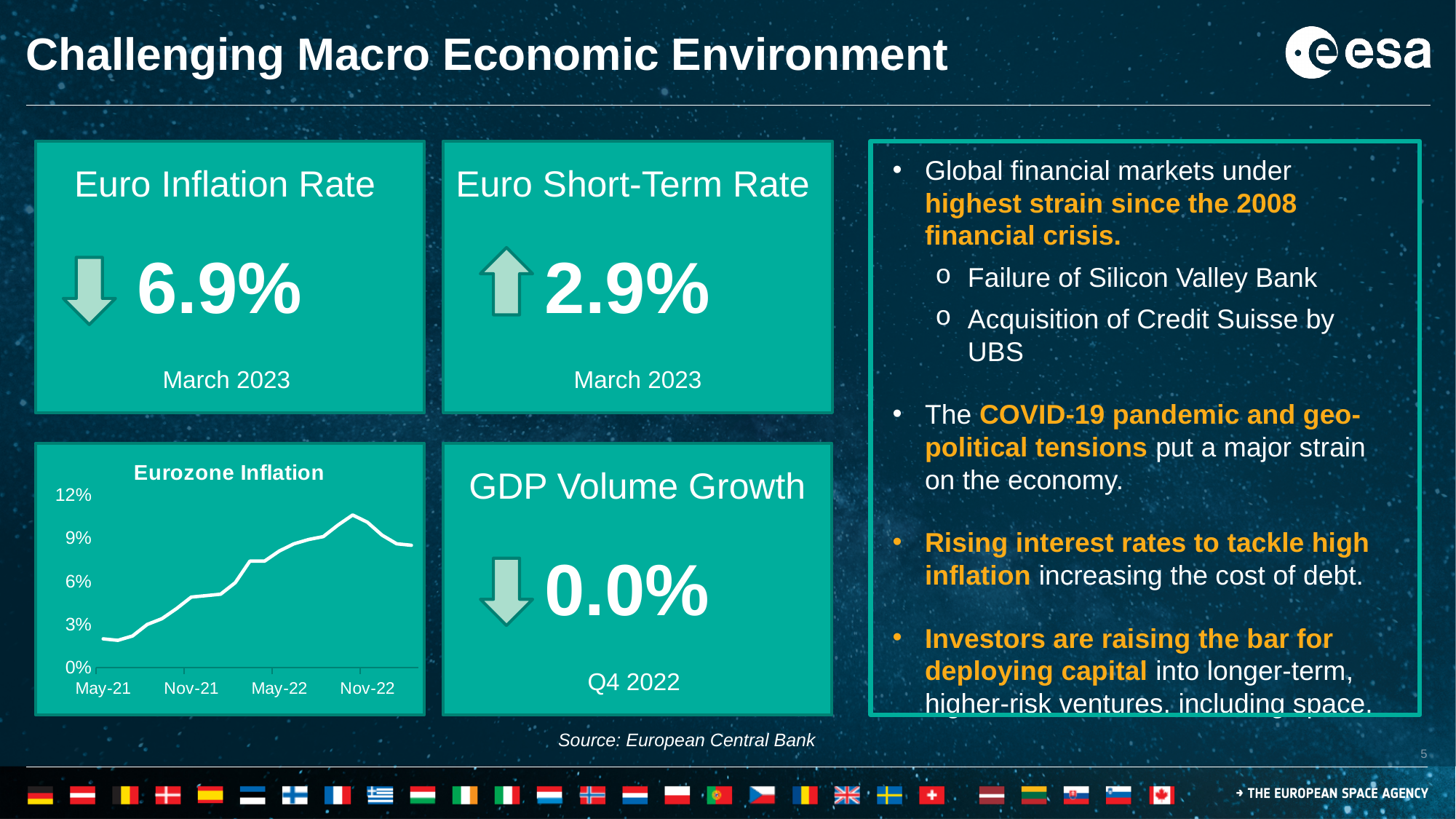
In the Eurozone Inflation chart, which is larger, the value at Nov-22 or the value at May-21? Nov-22 In the Eurozone Inflation chart, is the value at Nov-22 greater or less than 9%? greater In the Eurozone Inflation chart, is the value at Nov-21 greater or less than 6%? less In the Eurozone Inflation chart, does the inflation rate generally rise or fall from May-21 to Nov-22? rise What is the highest value shown on the y-axis of the Eurozone Inflation chart? 12% How many date labels are shown on the x-axis of the Eurozone Inflation chart? 4 In the Eurozone Inflation chart, is the value at May-22 greater or less than 6%? greater In the Eurozone Inflation chart, which x-axis label has the lowest inflation value? May-21 What is the title of the chart on the slide? Eurozone Inflation What kind of chart is the Eurozone Inflation chart? line chart